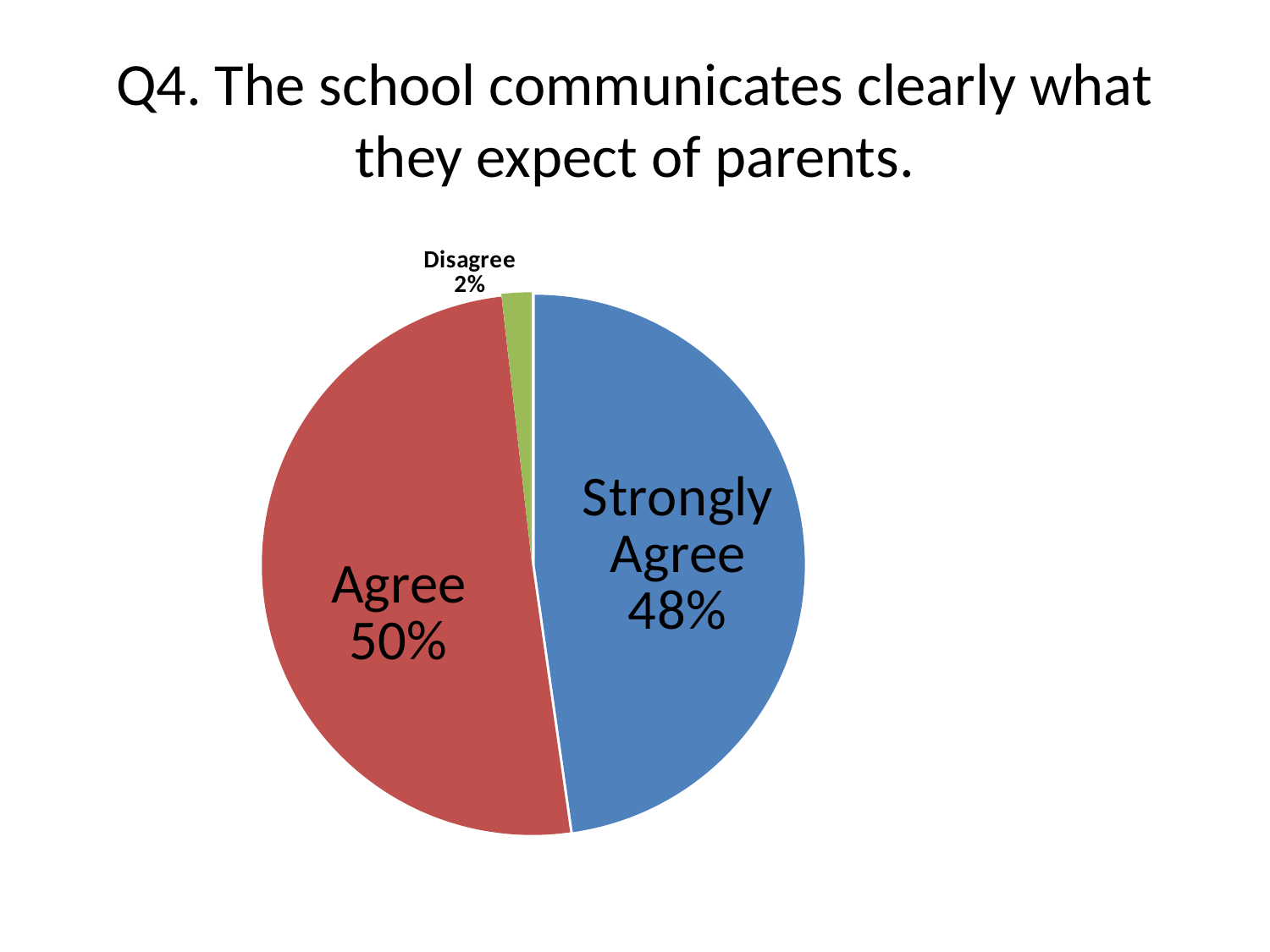
Which response has the largest share of the pie? Agree Which response has the smallest share of the pie? Disagree What percentage of respondents chose Agree? 50% What is the difference in percentage points between Strongly Agree and Disagree? 46 What percentage of respondents chose Disagree? 2% What kind of chart is shown on the slide? Pie chart What is the difference in percentage points between Agree and Strongly Agree? 2 What is the combined share of Agree and Strongly Agree? 98% What percentage of respondents chose Strongly Agree? 48% Which is larger, the share for Strongly Agree or the share for Disagree? Strongly Agree What colour is the Agree slice? Red How many slices does the pie chart have? 3